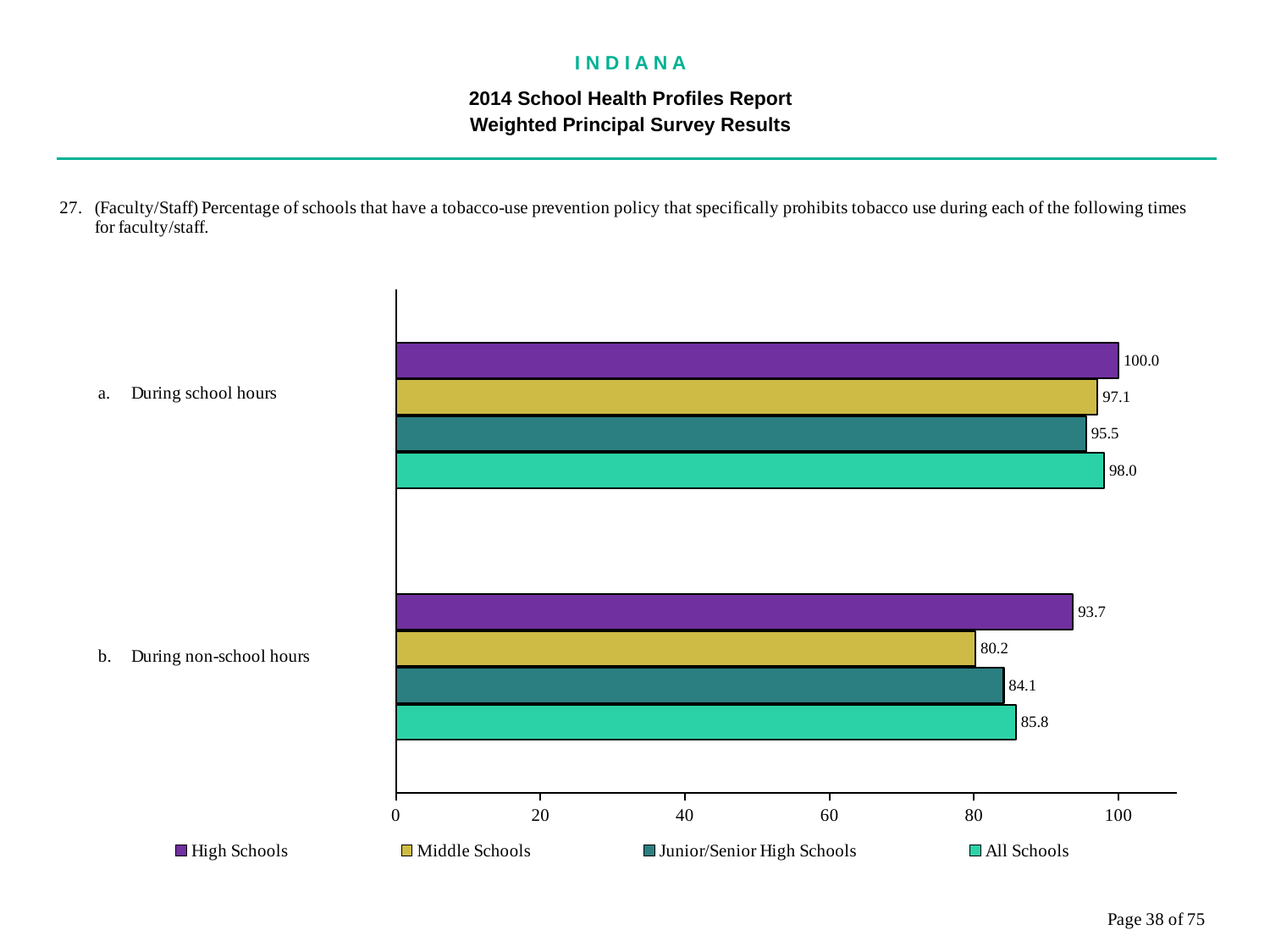
Which school type has the highest value during non-school hours? High Schools Is the value for Middle Schools during school hours greater or less than 80? greater How many series does the legend list? 4 What is the value for High Schools during school hours? 100.0 Which school type has the lowest value during school hours? Junior/Senior High Schools What kind of chart is shown on the slide? bar chart How many categories (time periods) are shown on the chart? 2 What is the difference between the High Schools values for school hours and non-school hours? 6.3 Which is larger: the Middle Schools value during non-school hours or the Junior/Senior High Schools value during non-school hours? Junior/Senior High Schools What is the value for All Schools during non-school hours? 85.8 What is the value for Middle Schools during non-school hours? 80.2 What is the value for Junior/Senior High Schools during school hours? 95.5